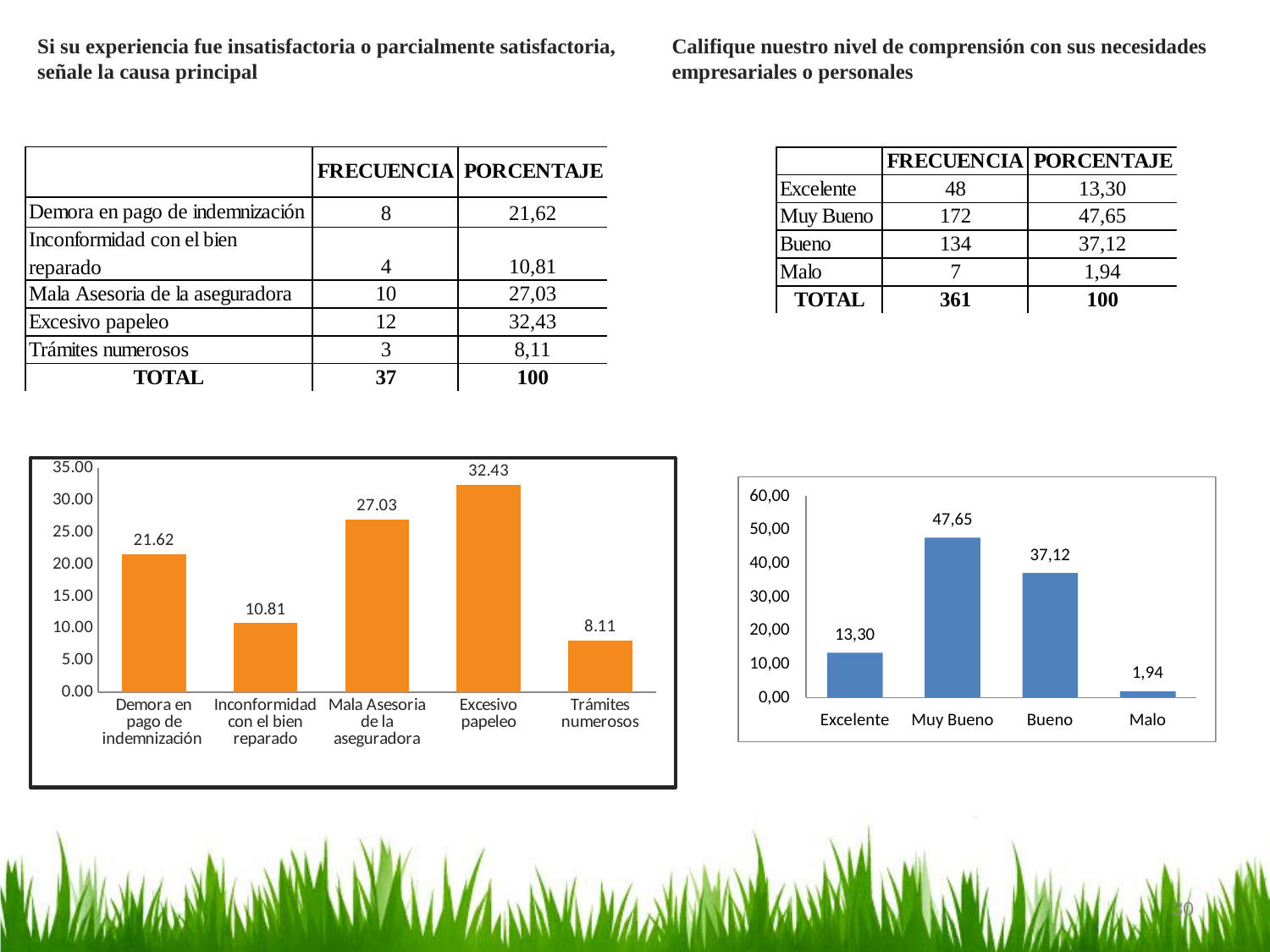
In the right chart, which category has the highest value? Muy Bueno In the right chart, what is the value for Malo? 1,94 In the right chart, which is larger, Excelente or Bueno? Bueno In the left chart, what is the difference between Mala Asesoria de la aseguradora and Demora en pago de indemnización? 5.41 In the left chart, what is the value for Excesivo papeleo? 32.43 In the left chart, which category has the highest value? Excesivo papeleo In the right chart, what is the value for Muy Bueno? 47,65 In the left chart, what is the value for Inconformidad con el bien reparado? 10.81 In the left chart, which category has the lowest value? Trámites numerosos How many bars are in the left chart? 5 What type of chart is the left chart? Bar chart In the right chart, what is the difference between Muy Bueno and Bueno? 10,53